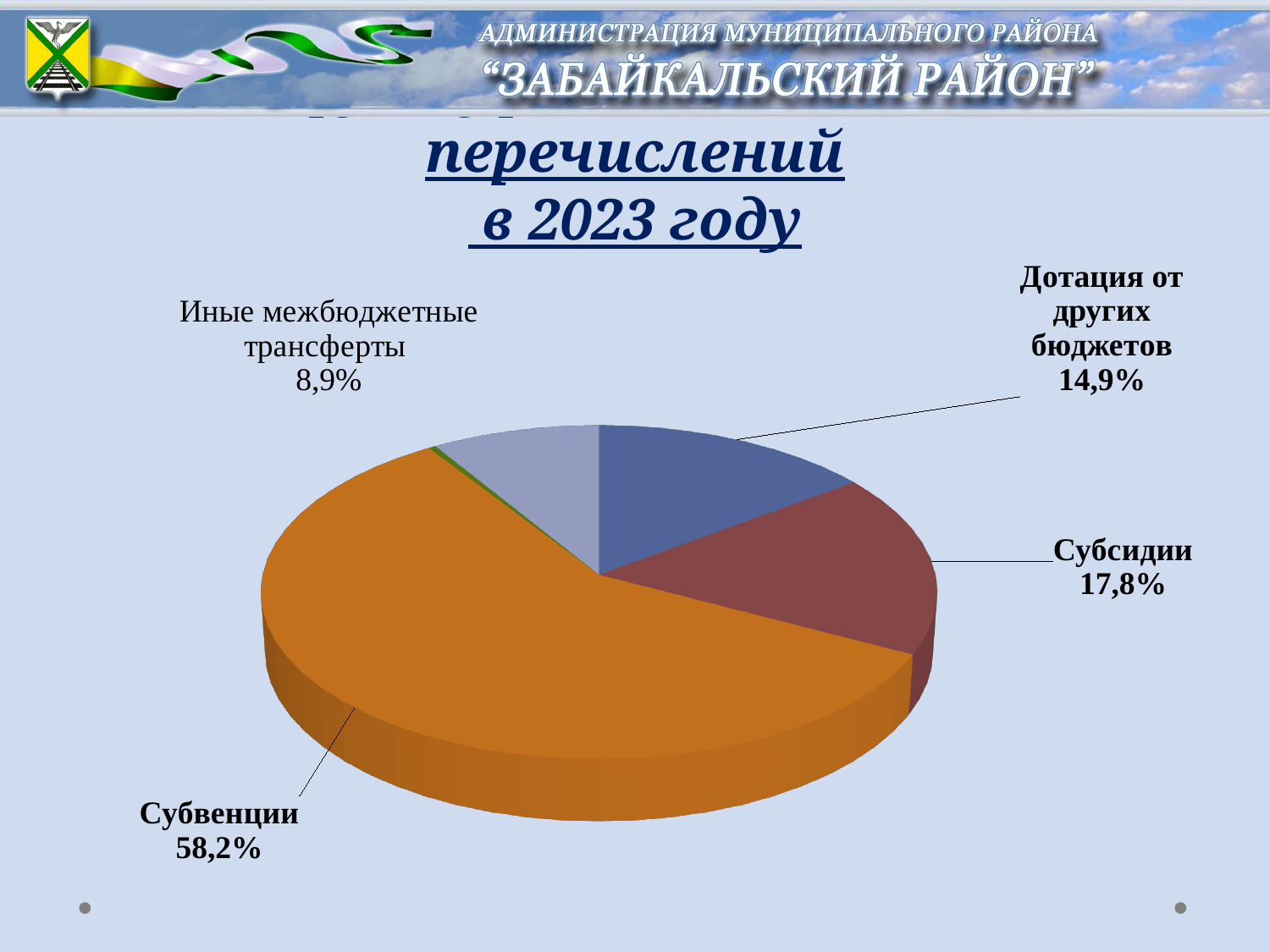
Which category has the largest share of the pie? Субвенции What share of the pie does Дотация от других бюджетов have? 14,9% What share of the pie does Субсидии have? 17,8% What share of the pie does Субвенции have? 58,2% What is the difference in percentage points between Субсидии and Дотация от других бюджетов? 2,9 What kind of chart is shown on the slide? Pie chart Which is larger, the share for Субсидии or the share for Дотация от других бюджетов? Субсидии What share of the pie does Иные межбюджетные трансферты have? 8,9% Which labelled category has the smallest share of the pie? Иные межбюджетные трансферты What colour is the Субвенции slice of the pie? Orange What is the difference in percentage points between Субвенции and Субсидии? 40,4 Which is larger, the share for Иные межбюджетные трансферты or the share for Дотация от других бюджетов? Дотация от других бюджетов